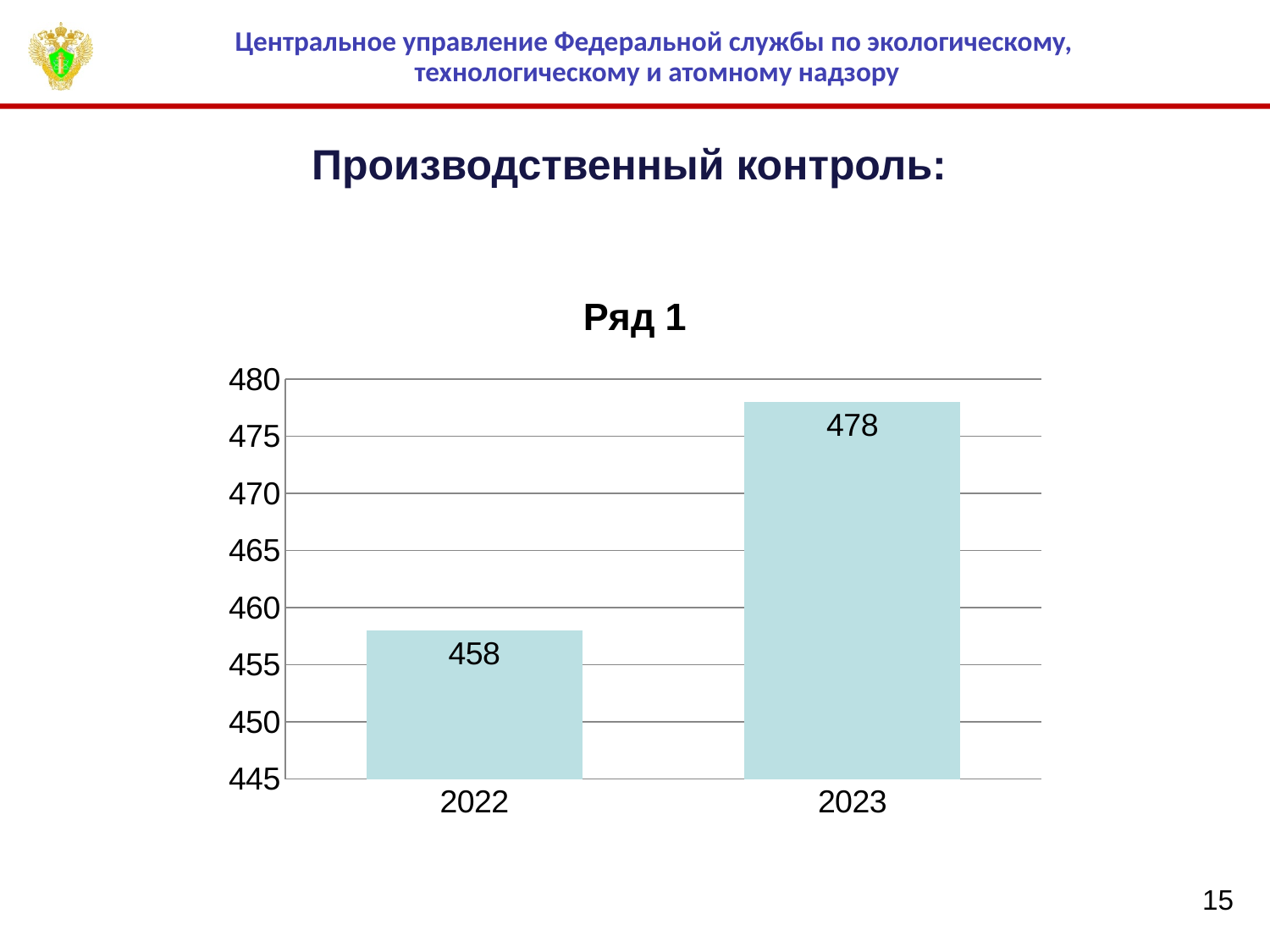
Which is larger, the value for 2022 or the value for 2023? 2023 Do the values rise or fall from 2022 to 2023? rise What kind of chart is shown on the slide? bar chart What is the difference between the values for 2023 and 2022? 20 Which year has the lowest value? 2022 Is the value for 2022 greater or less than 460? less What is the value for 2022? 458 How many categories are shown on the x axis? 2 What is the title of the chart? Ряд 1 What is the value for 2023? 478 Is the value for 2023 greater or less than 475? greater Which year has the highest value? 2023